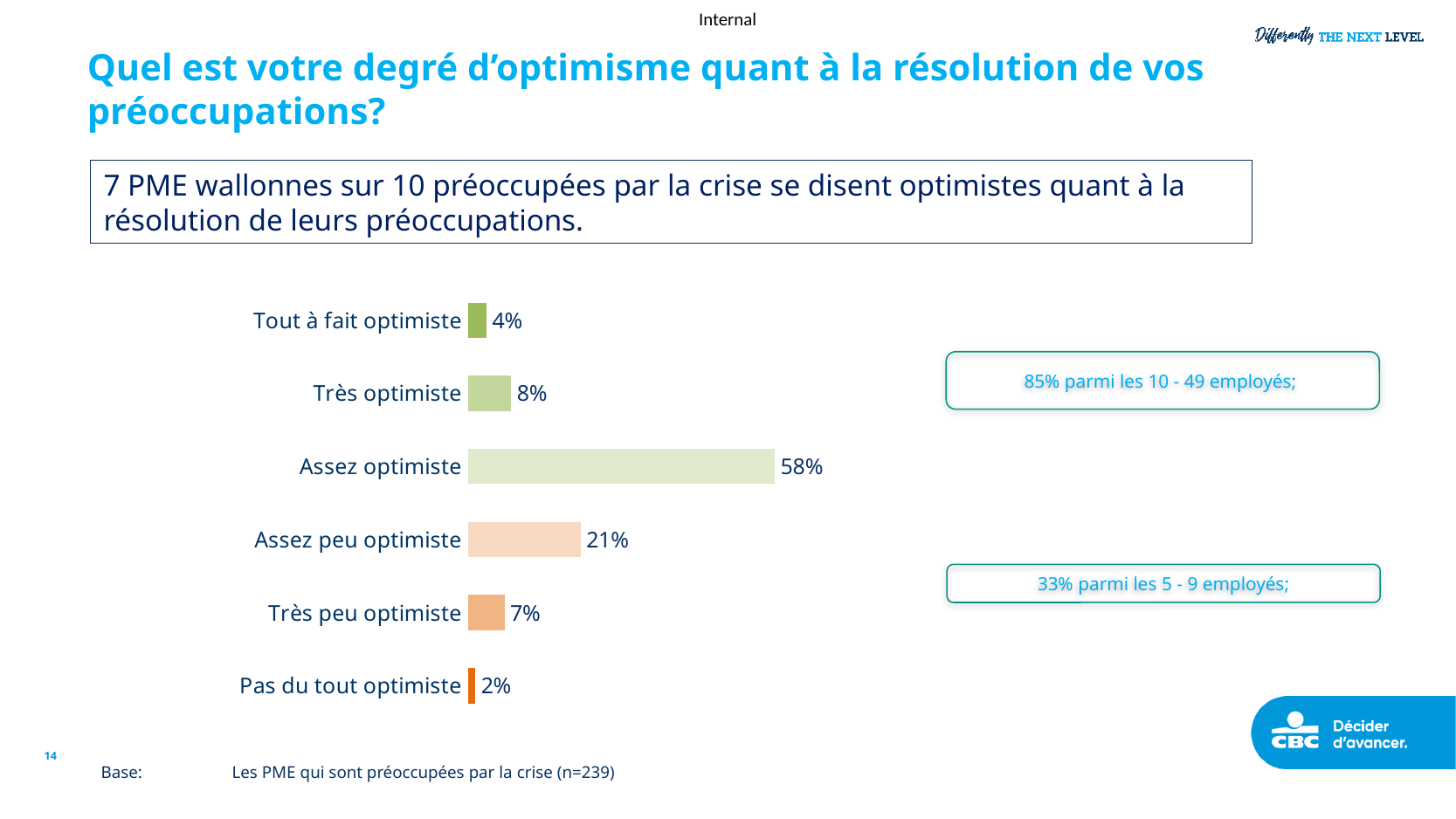
Which category has the highest value? Assez optimiste What is the value for "Tout à fait optimiste"? 4% What is the value for "Assez optimiste"? 58% What is the base (n) stated for the chart? n=239 Which is larger, "Très optimiste" or "Très peu optimiste"? Très optimiste What is the difference between "Assez optimiste" and "Assez peu optimiste"? 37% What is the difference between "Très optimiste" and "Pas du tout optimiste"? 6% What is the value for "Très peu optimiste"? 7% What is the value for "Assez peu optimiste"? 21% Which category has the lowest value? Pas du tout optimiste What kind of chart is shown on the slide? Bar chart How many categories are shown in the chart? 6